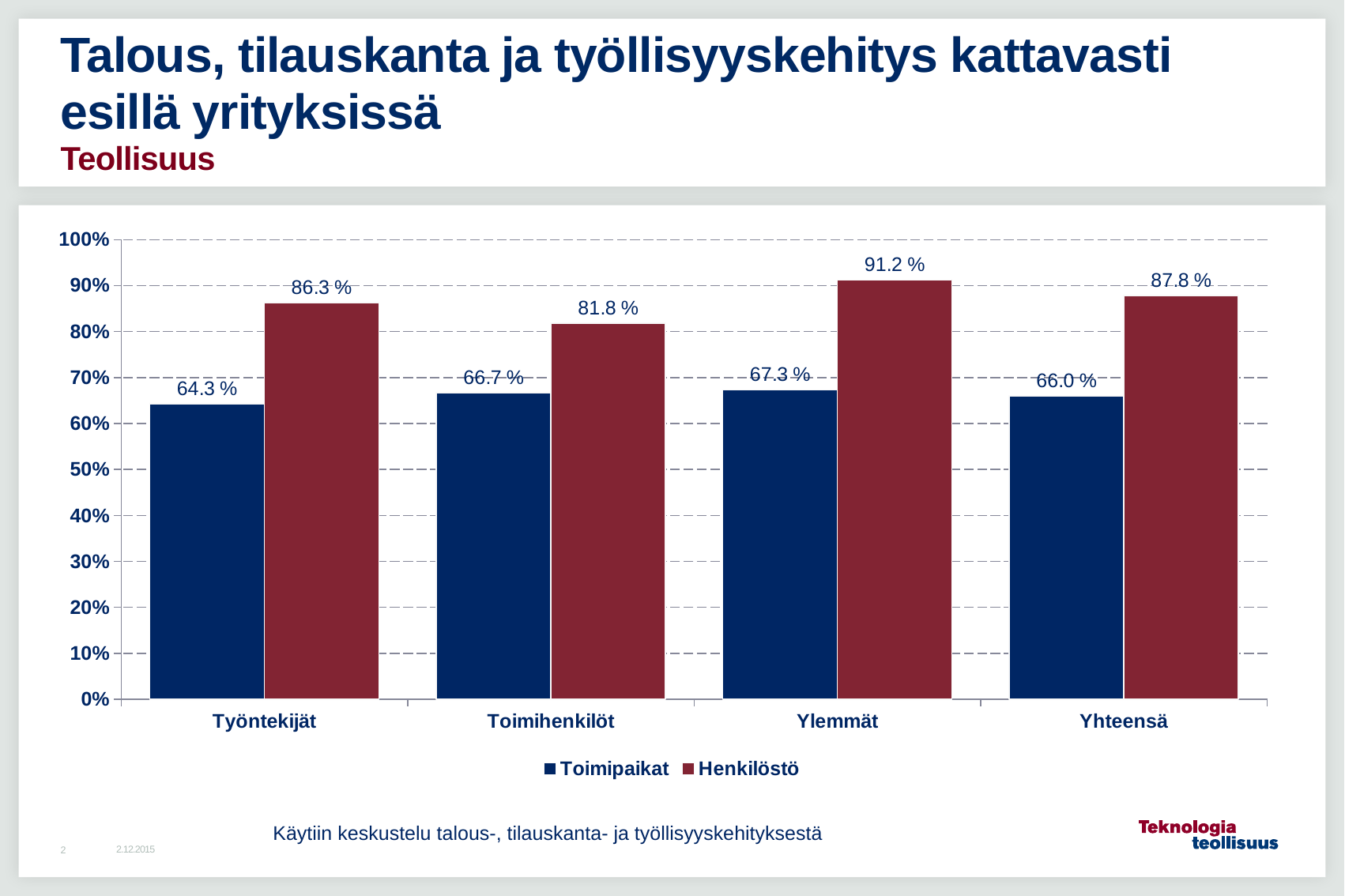
What kind of chart is shown on the slide? Bar chart What is the Henkilöstö value for Toimihenkilöt? 81.8 % What is the Toimipaikat value for Työntekijät? 64.3 % What is the Henkilöstö value for Ylemmät? 91.2 % For Yhteensä, which series has the larger value, Toimipaikat or Henkilöstö? Henkilöstö How many series does the legend list? 2 Which category has the lowest Henkilöstö value? Toimihenkilöt What is the difference between the Henkilöstö and Toimipaikat values for Ylemmät? 23.9 % How many categories are shown on the x axis? 4 Which category has the highest Henkilöstö value? Ylemmät Which category has the lowest Toimipaikat value? Työntekijät What is the Toimipaikat value for Yhteensä? 66.0 %